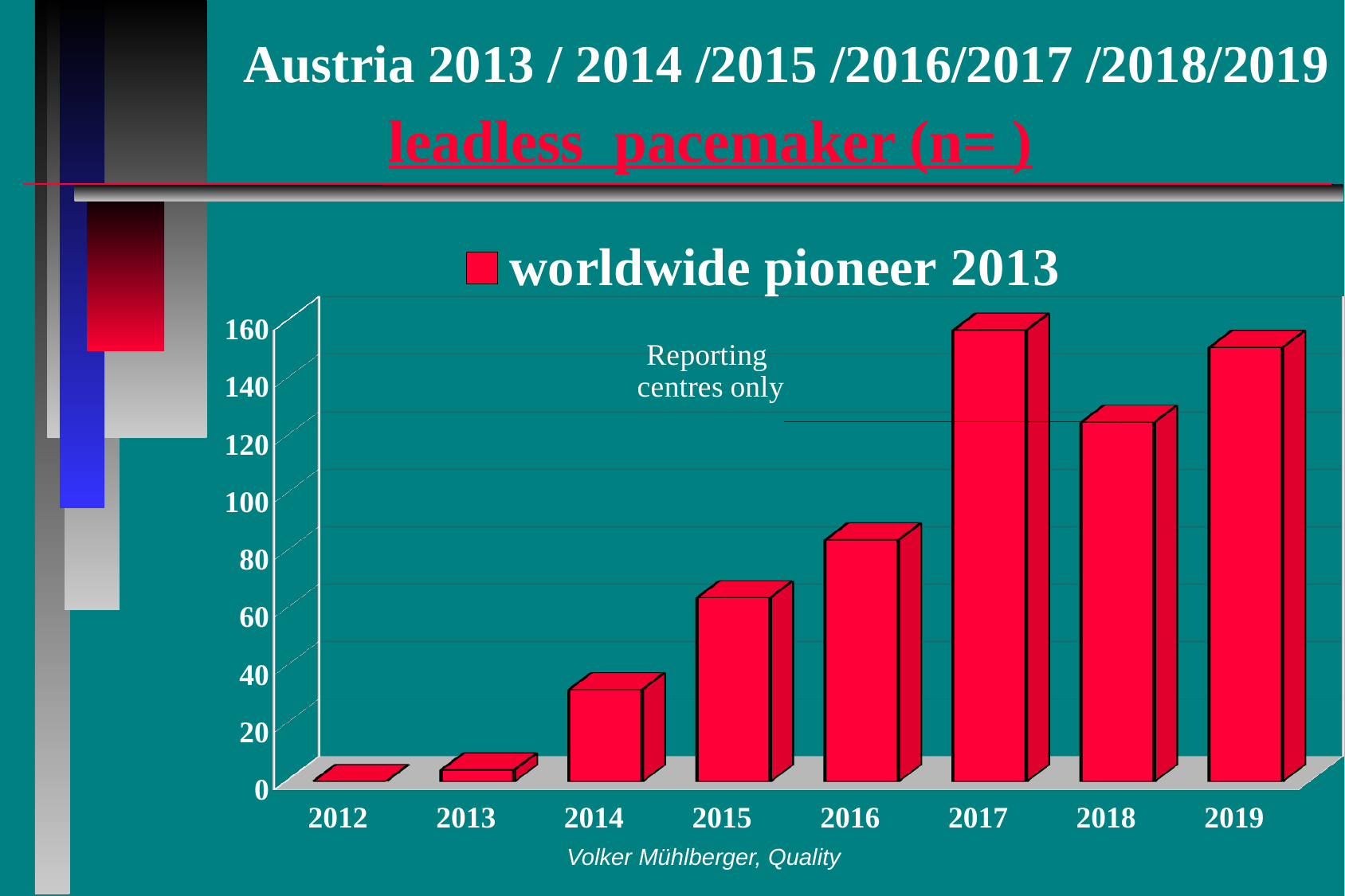
Is the value for 2017 greater or less than 140? greater What kind of chart is shown on the slide? bar chart Is the value for 2018 greater or less than 100? greater Is the value for 2014 greater or less than 40? less Which year has the highest bar in the chart? 2017 What is the legend entry of the chart? worldwide pioneer 2013 Which is larger, the value for 2017 or the value for 2018? 2017 Do the values rise or fall from 2012 to 2017? rise How many years are shown on the x axis of the chart? 8 How many series does the chart legend list? 1 Which year has the lowest bar in the chart? 2012